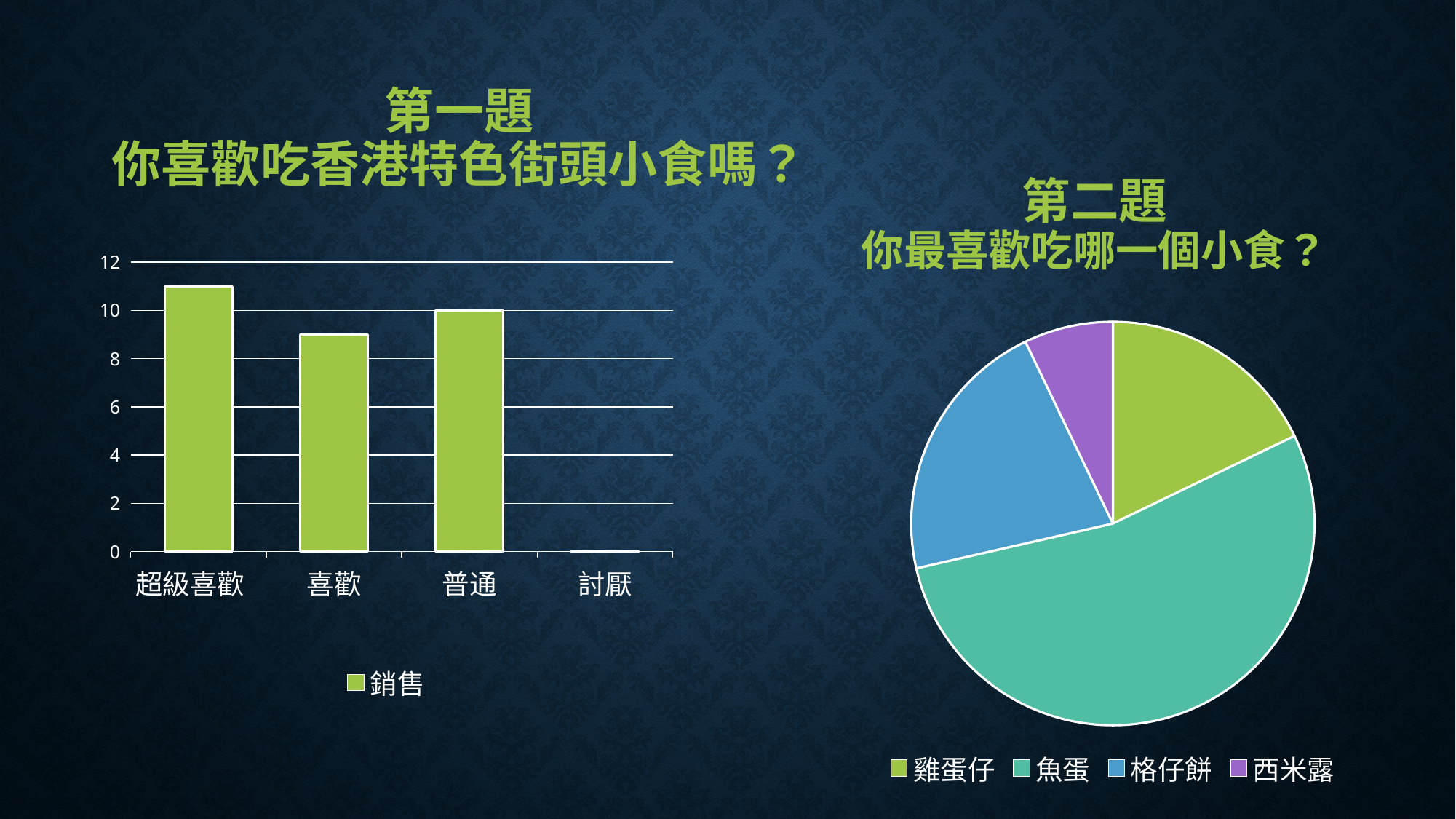
On the pie chart titled 第二題, which slice is the largest? 魚蛋 On the bar chart titled 第一題, what is the value for 討厭? 0 On the bar chart titled 第一題, is the value for 喜歡 greater or less than 10? less On the bar chart titled 第一題, which is larger, the value for 喜歡 or the value for 普通? 普通 On the bar chart titled 第一題, is the value for 超級喜歡 greater or less than 10? greater On the bar chart titled 第一題, what is the value for 普通? 10 On the bar chart titled 第一題, which category has the lowest value? 討厭 On the pie chart titled 第二題, which slice is the smallest? 西米露 How many series does the legend of the bar chart titled 第一題 list? 1 On the bar chart titled 第一題, which category has the highest value? 超級喜歡 How many categories are shown on the bar chart titled 第一題? 4 What kind of chart is the chart titled 第二題? pie chart